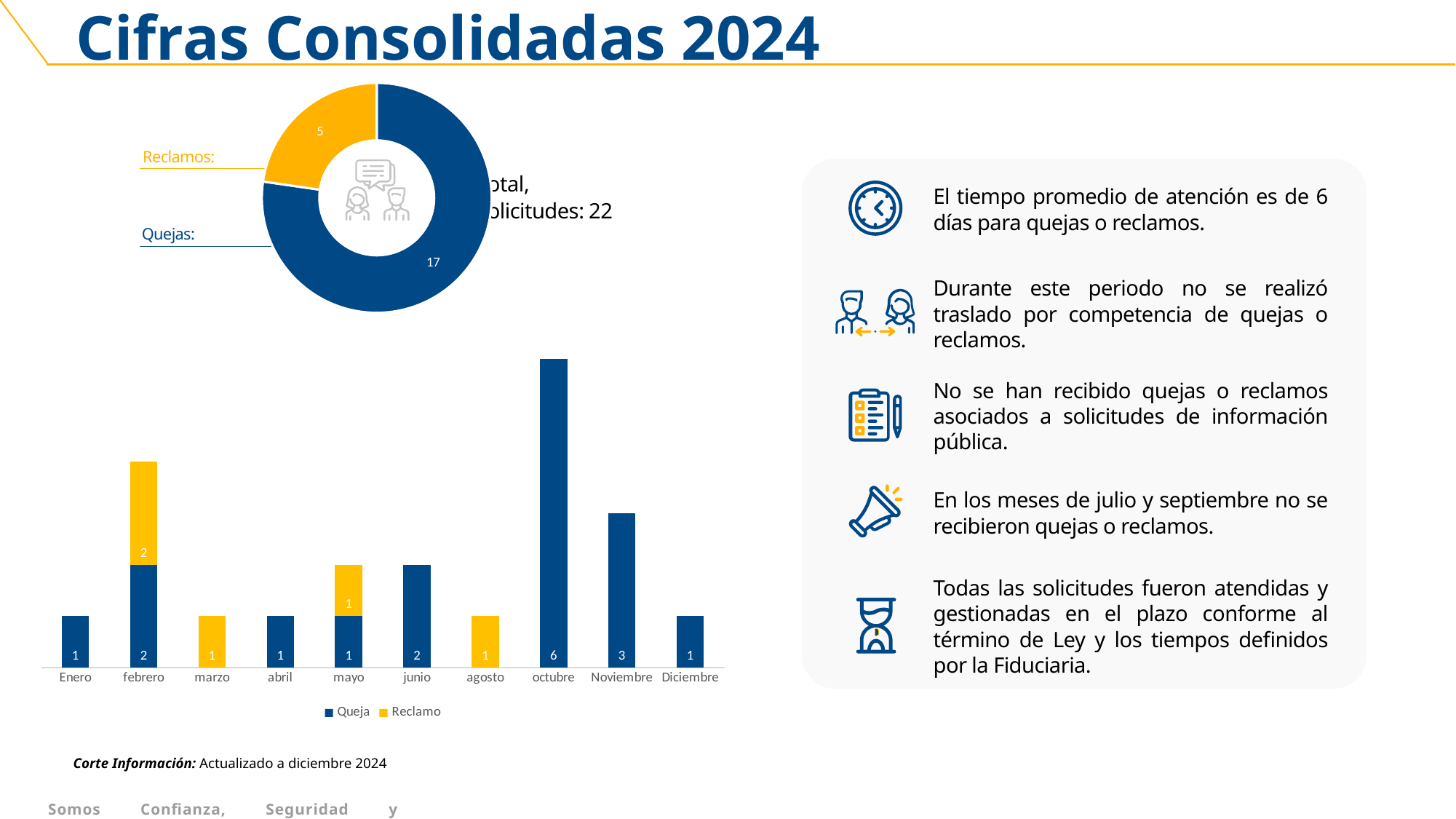
In the donut chart at the top, what is the difference between Quejas and Reclamos? 12 In the donut chart at the top, what is the value for Reclamos? 5 In the donut chart at the top, what is the value for Quejas? 17 In the bar chart at the bottom, which month has the highest Queja value? octubre In the bar chart at the bottom, what is the Reclamo value for febrero? 2 In the bar chart at the bottom, what is the Queja value for octubre? 6 In the bar chart at the bottom, what is the total of the stacked bar for febrero? 4 What type of chart is the chart at the bottom of the slide? Stacked bar chart In the bar chart at the bottom, what is the total of the stacked bar for mayo? 2 In the bar chart at the bottom, how many series does the legend list? 2 In the donut chart at the top, which segment is larger, Quejas or Reclamos? Quejas In the bar chart at the bottom, how many months are shown on the x axis? 10